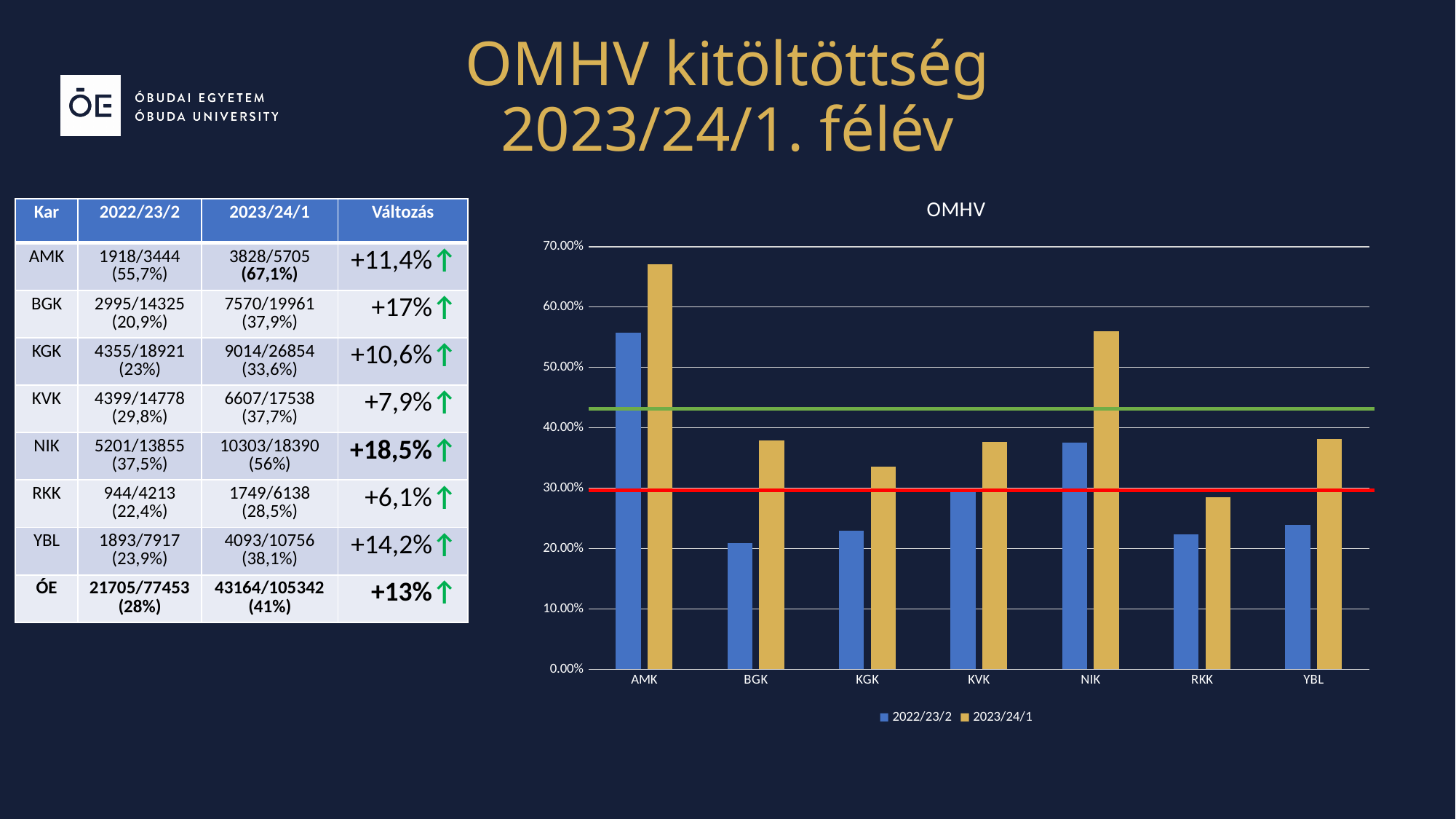
What kind of chart is shown on the slide? bar chart What is the title of the chart? OMHV How many categories are shown on the x axis of the chart? 7 Which category has the lowest value for the 2023/24/1 series? RKK Which category has the highest value for the 2022/23/2 series? AMK How many series does the chart legend list? 2 Is the 2023/24/1 value for AMK greater or less than 60.00%? greater Is the 2023/24/1 value for NIK greater or less than 50.00%? greater Which is larger for the 2022/23/2 series: the value for NIK or the value for KVK? NIK Is the 2023/24/1 value for RKK greater or less than 30.00%? less Which colour represents the 2023/24/1 series in the chart? gold Which category has the highest value for the 2023/24/1 series? AMK